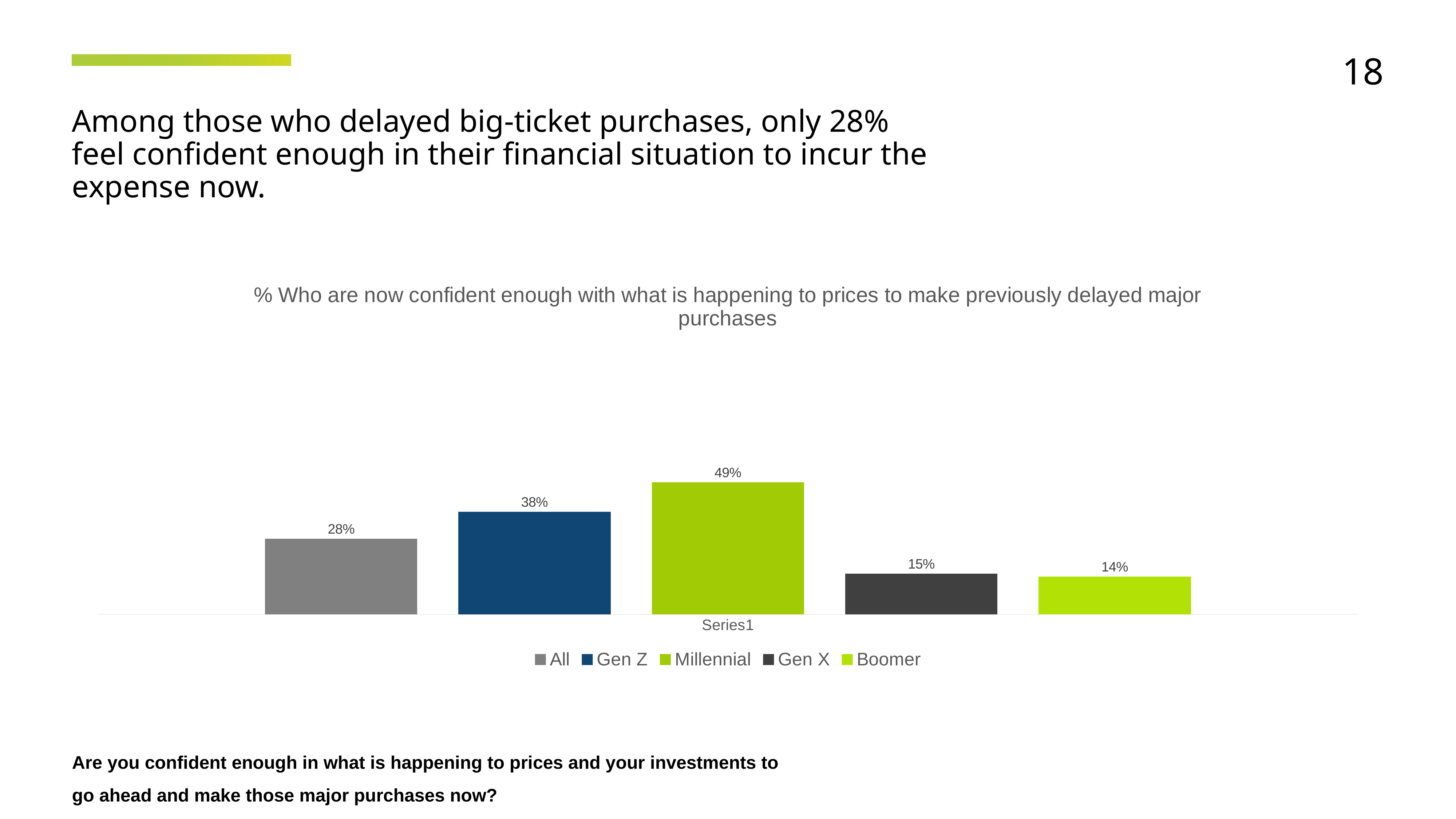
What is the value for Gen X? 15% Which group has the highest value? Millennial What is the difference between the Millennial and Gen Z values? 11% What kind of chart is shown on the slide? Bar chart What is the title of the chart? % Who are now confident enough with what is happening to prices to make previously delayed major purchases Which is larger, the value for Gen Z or the value for All? Gen Z What is the value for Gen Z? 38% How many series does the legend list? 5 What is the value for Boomer? 14% What is the value for All? 28% Which group has the lowest value? Boomer What is the value for Millennial? 49%